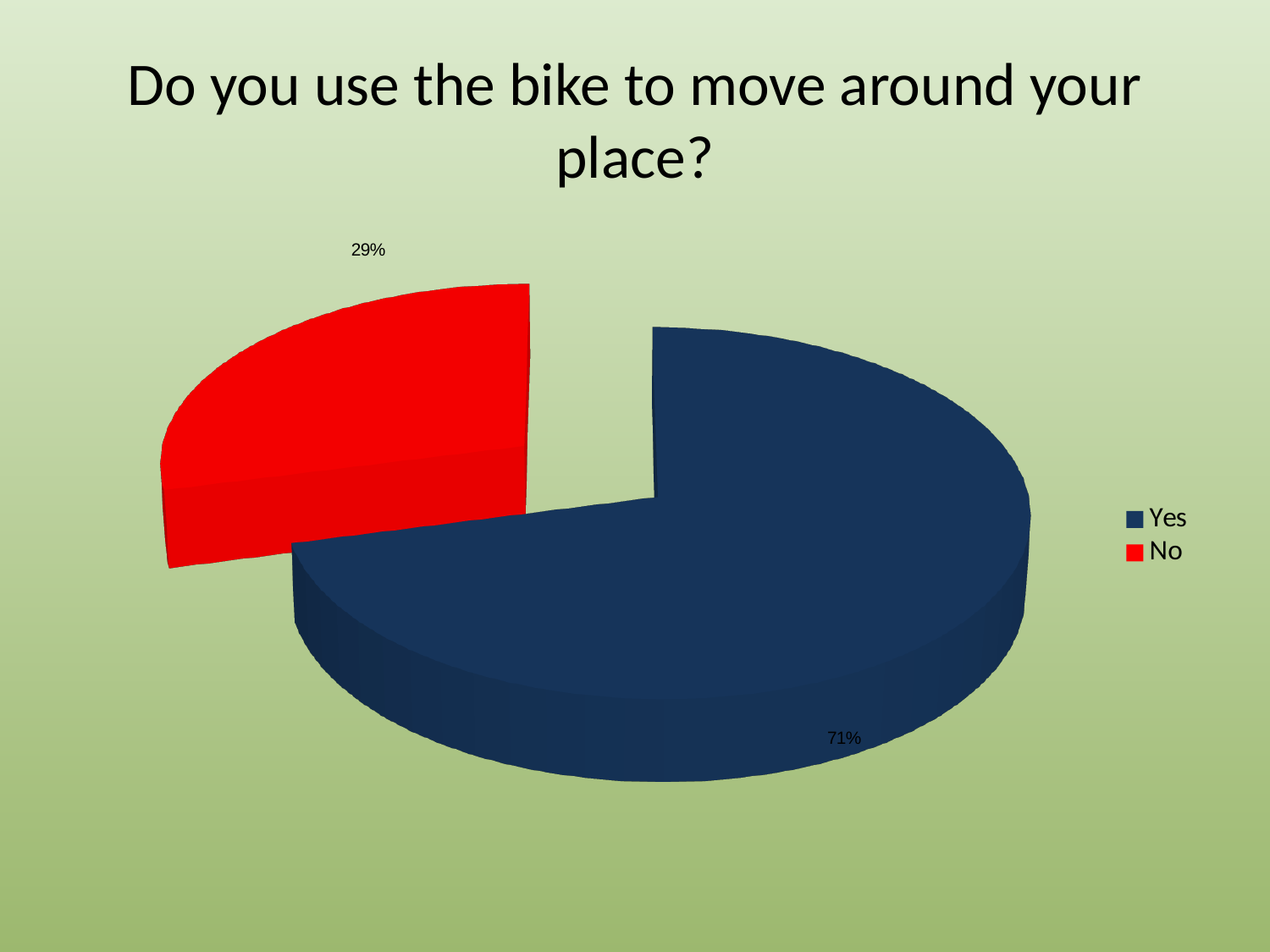
Which response has the largest share of the pie? Yes What percentage of respondents answered No? 29% What share of the pie does the No slice represent? 29% What percentage of respondents answered Yes? 71% What colour is the Yes slice? Dark blue Which is larger, the share for Yes or the share for No? Yes How many slices does the pie chart have? 2 What is the title of the chart? Do you use the bike to move around your place? What kind of chart is shown on the slide? Pie chart What is the difference in percentage points between the Yes and No shares? 42 Which response has the smallest share of the pie? No How many entries does the legend list? 2